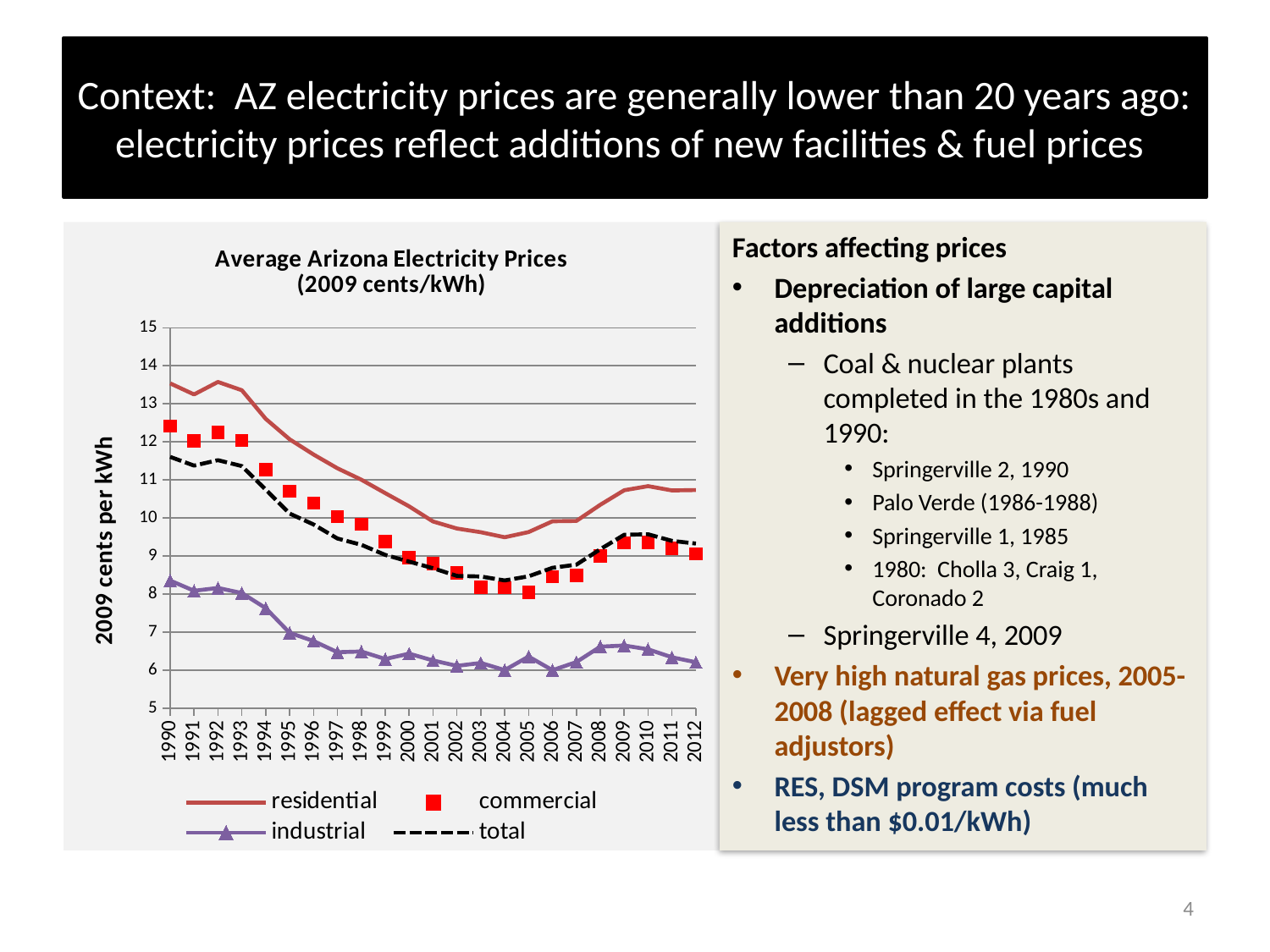
Does the residential price rise or fall from 1990 to 2004? fall Is the residential price in 1990 greater or less than 13? greater What kind of chart is shown on the slide? line chart Which series has the highest price in 1990? residential Is the industrial price in 2004 greater or less than 7? less Which series has the lowest price across the whole period? industrial How many series does the chart legend list? 4 What is the label on the vertical axis of the chart? 2009 cents per kWh Is the commercial price in 2005 greater or less than 9? less Which is higher in 2000, the residential price or the industrial price? residential What is the title of the chart? Average Arizona Electricity Prices (2009 cents/kWh) How many years are plotted along the x axis of the chart? 23